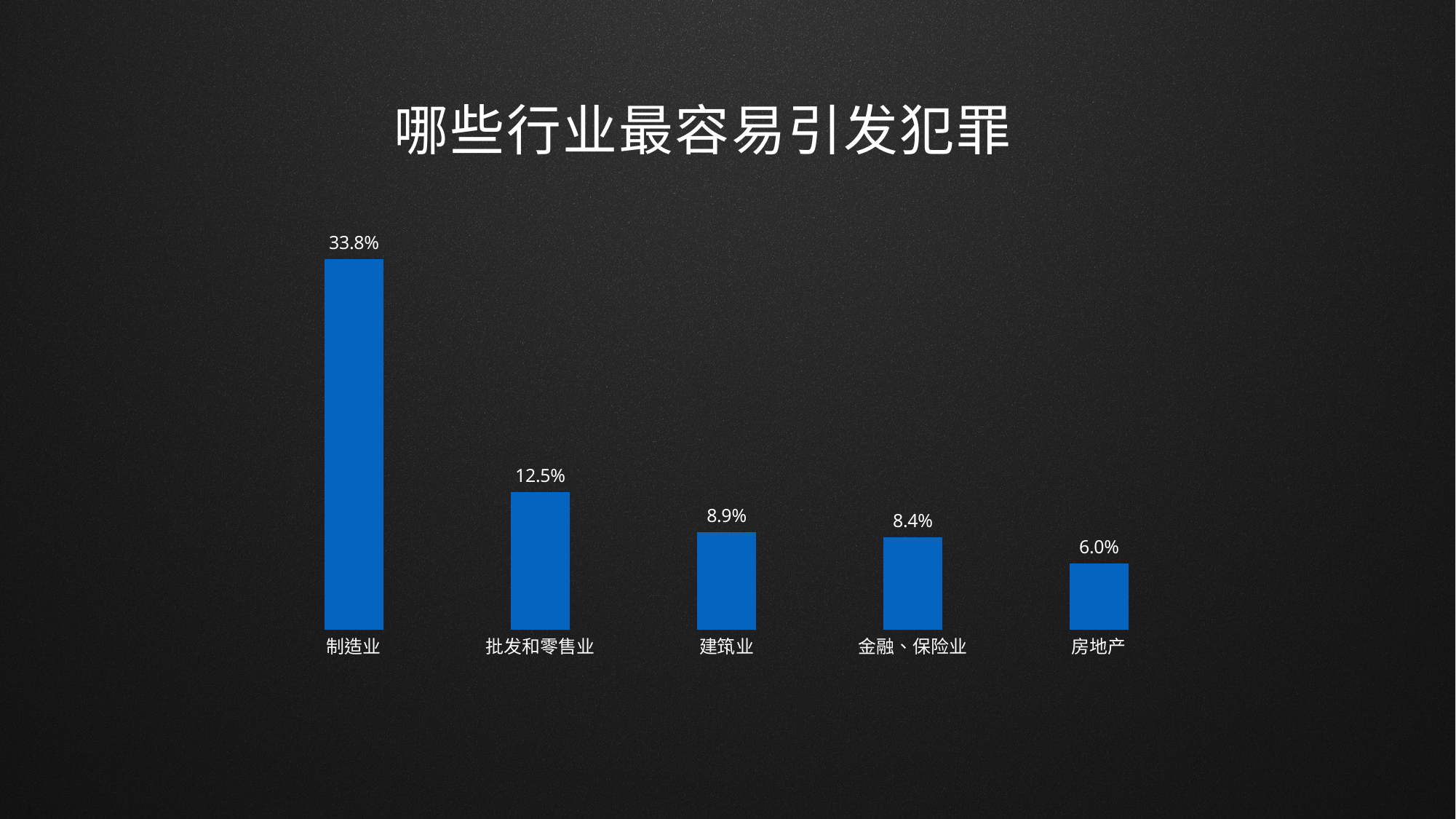
What is the value for 批发和零售业? 12.5% What is the title of the slide? 哪些行业最容易引发犯罪 What is the value for 制造业? 33.8% Which is larger, the value for 建筑业 or the value for 房地产? 建筑业 What is the difference between the values for 制造业 and 批发和零售业? 21.3% How many categories are shown in the chart? 5 What is the value for 金融、保险业? 8.4% What is the value for 建筑业? 8.9% What is the value for 房地产? 6.0% Which category has the highest value? 制造业 What kind of chart is shown on the slide? bar chart Which category has the lowest value? 房地产